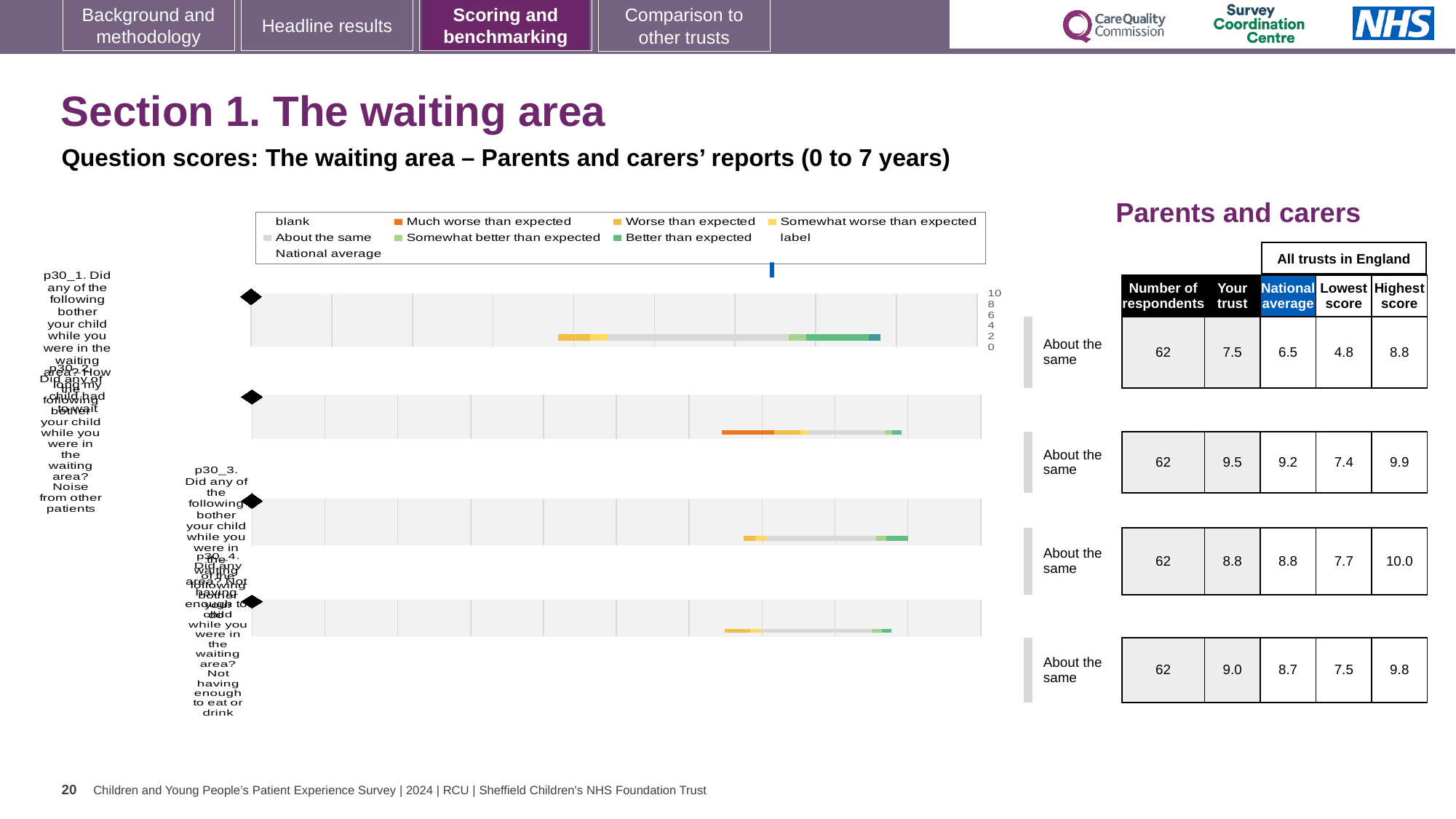
What kind of chart is shown on the left of the slide? bar chart In the table on the right, what is the difference between 'Your trust' and 'National average' in the first row? 1.0 What colour does the legend use for 'Better than expected'? green In the table on the right, what is the 'Your trust' score in the first row? 7.5 In the table on the right, what is the 'National average' in the second row? 9.2 In the table on the right, what is the 'Lowest score' in the fourth row? 7.5 How many entries does the chart legend list? 9 In the table on the right, what is the 'Highest score' in the third row? 10.0 What colour does the legend use for 'Much worse than expected'? orange In the table on the right, which row has the highest 'Your trust' score? the second row (9.5) In the table on the right, how many respondents are listed for each row? 62 How many horizontal bars are plotted in the chart? 4